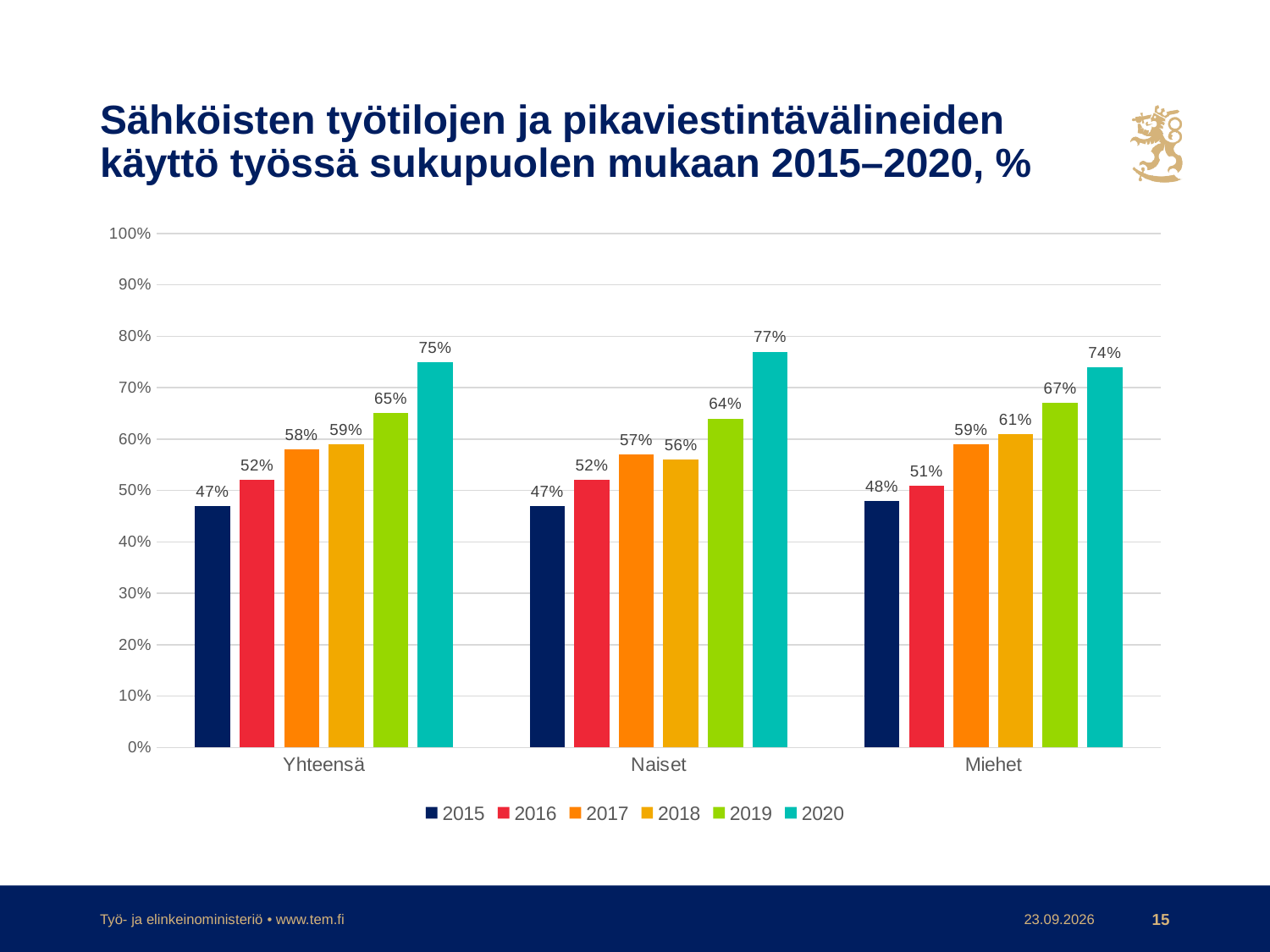
Which is larger for 2018: the value for Naiset or the value for Miehet? Miehet Is the value for Miehet in 2019 greater or less than 60%? greater Do the values for Naiset generally rise or fall from 2015 to 2020? Rise What is the value for Yhteensä in 2015? 47% What kind of chart is shown on the slide? Bar chart How many series does the legend list? 6 What is the difference between the 2020 and 2015 values for Yhteensä? 28 percentage points What is the value for Naiset in 2020? 77% Which year has the lowest value for Miehet? 2015 Which category has the highest value in 2020? Naiset How many categories are shown on the x axis? 3 What is the value for Miehet in 2017? 59%